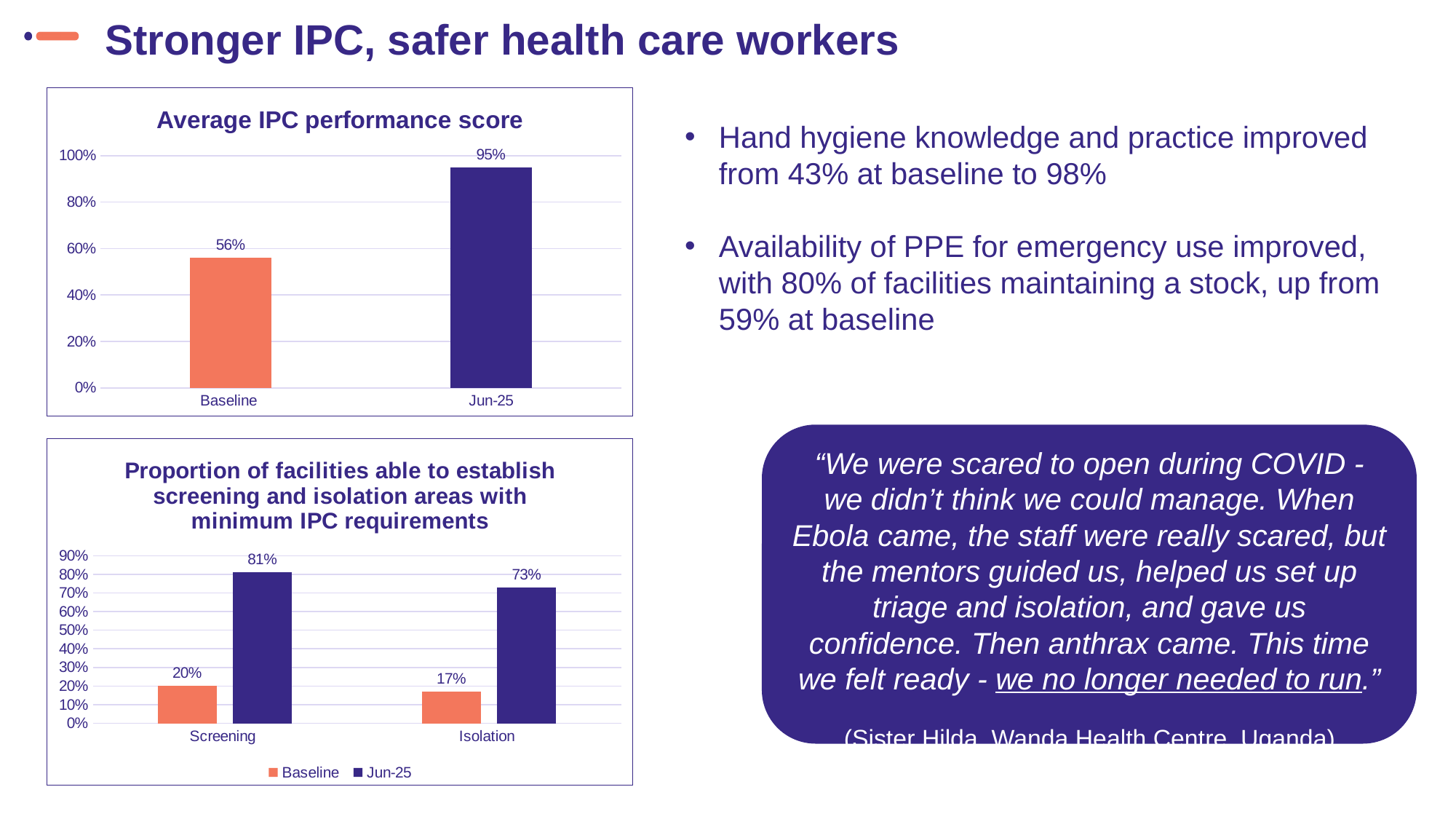
In the 'Proportion of facilities able to establish screening and isolation areas' chart, which colour represents the Jun-25 series? Dark purple In the 'Proportion of facilities able to establish screening and isolation areas' chart, how many series does the legend list? 2 In the 'Proportion of facilities able to establish screening and isolation areas' chart, how many categories are shown on the x axis? 2 In the 'Proportion of facilities able to establish screening and isolation areas' chart, what is the difference between the Jun-25 and Baseline values for Screening? 61% In the 'Average IPC performance score' chart, what is the difference between the Jun-25 and Baseline values? 39% In the 'Average IPC performance score' chart, what is the value for Jun-25? 95% In the 'Average IPC performance score' chart, which category has the higher value? Jun-25 In the 'Proportion of facilities able to establish screening and isolation areas' chart, what is the Baseline value for Screening? 20% In the 'Proportion of facilities able to establish screening and isolation areas' chart, which is larger: the Baseline value for Screening or the Baseline value for Isolation? Screening In the 'Proportion of facilities able to establish screening and isolation areas' chart, what is the Jun-25 value for Isolation? 73% In the 'Average IPC performance score' chart, what is the value for Baseline? 56% What kind of chart is the 'Average IPC performance score' chart? Bar chart